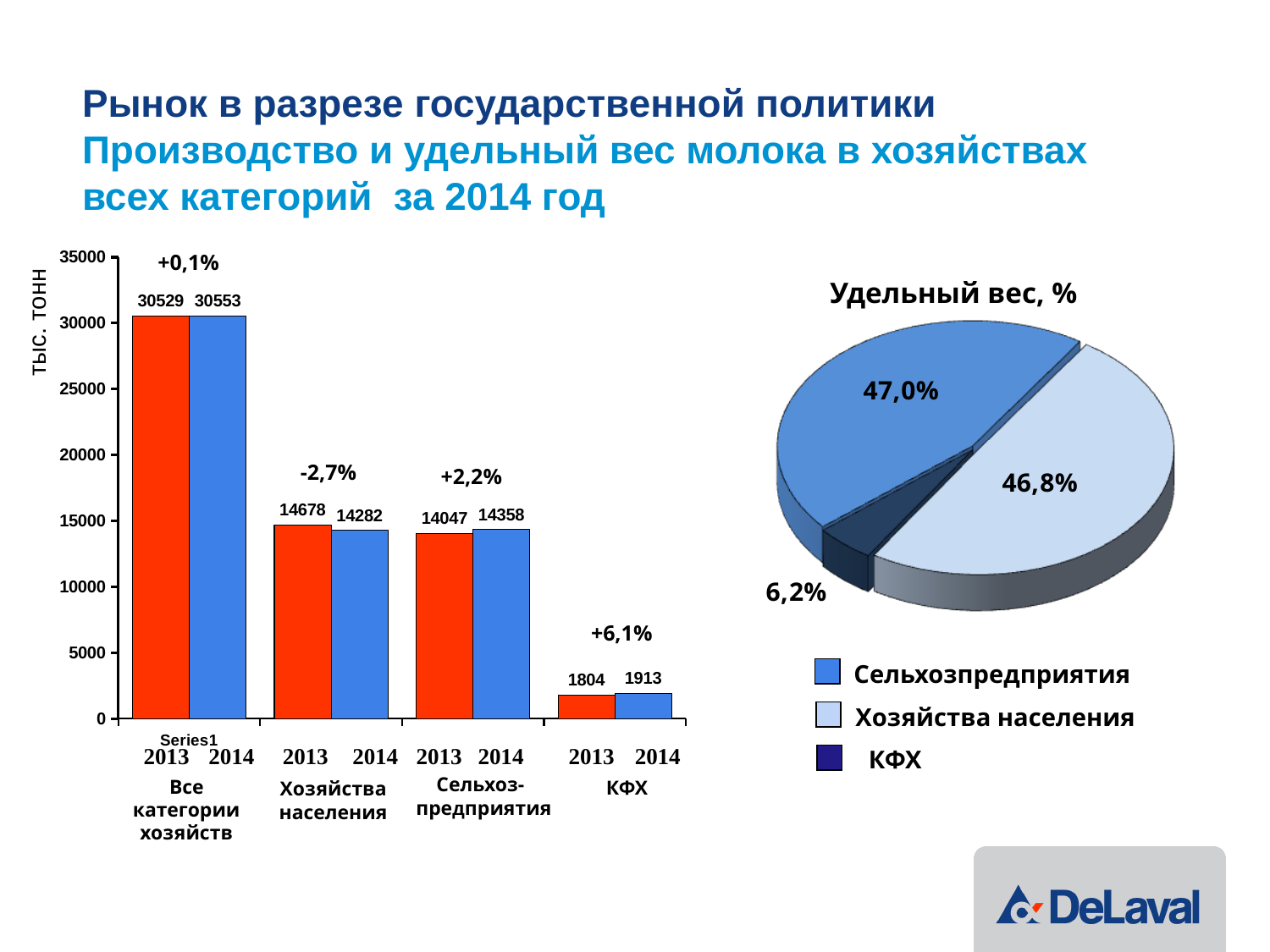
What type of chart is the chart on the left? bar chart In the bar chart on the left, what is the difference between the 2014 and 2013 values for Сельхозпредприятия? 311 In the bar chart on the left, which is larger for Хозяйства населения: the 2013 value or the 2014 value? 2013 How many entries does the legend of the pie chart Удельный вес, % list? 3 In the pie chart Удельный вес, %, which category has the smallest share? КФХ In the bar chart on the left, what was the value for Хозяйства населения in 2013? 14678 In the bar chart on the left, how many categories are shown on the x axis? 4 In the bar chart on the left, what was the value for КФХ in 2014? 1913 In the bar chart on the left, which category has the lowest values? КФХ In the bar chart on the left, what was the value for Все категории хозяйств in 2014? 30553 In the pie chart Удельный вес, %, what share does Сельхозпредприятия have? 47,0% In the bar chart on the left, what percentage change is shown above the Сельхозпредприятия bars? +2,2%